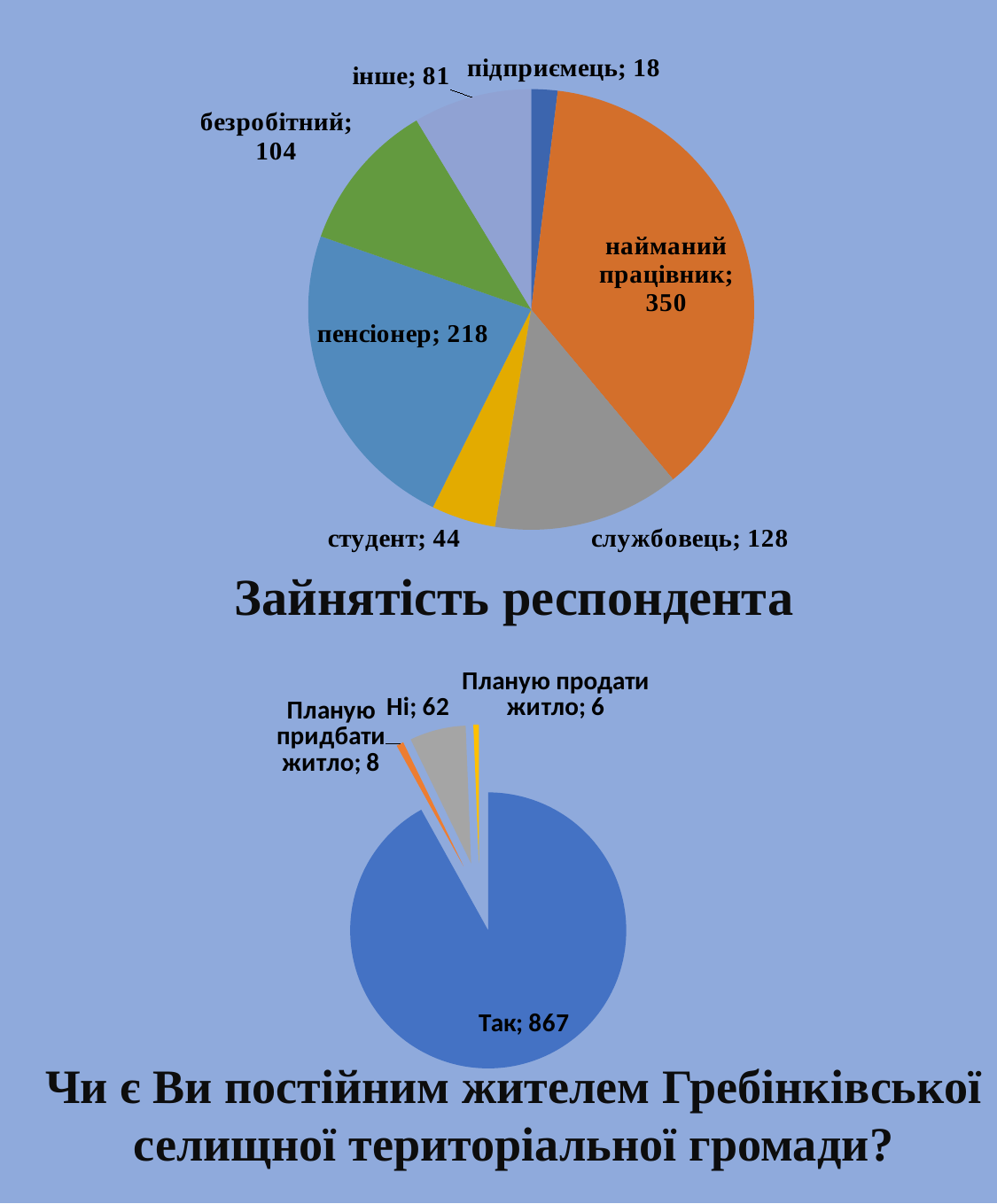
In the bottom chart ("Чи є Ви постійним жителем Гребінківської селищної територіальної громади?"), what is the value for "Ні"? 62 What type of chart is the top chart, "Зайнятість респондента"? pie chart In the chart titled "Зайнятість респондента", what is the value for "пенсіонер"? 218 In the chart titled "Зайнятість респондента", which is larger: "студент" or "інше"? інше In the chart titled "Зайнятість респондента", what is the difference between "службовець" and "безробітний"? 24 In the bottom chart ("Чи є Ви постійним жителем Гребінківської селищної територіальної громади?"), which category has the smallest value? Планую продати житло In the bottom chart ("Чи є Ви постійним жителем Гребінківської селищної територіальної громади?"), what is the difference between "Планую придбати житло" and "Планую продати житло"? 2 How many categories does the chart titled "Зайнятість респондента" show? 7 In the chart titled "Зайнятість респондента", which category has the smallest slice? підприємець In the bottom chart ("Чи є Ви постійним жителем Гребінківської селищної територіальної громади?"), how many respondents answered "Так"? 867 In the chart titled "Зайнятість респондента", how many respondents are "найманий працівник"? 350 In the chart titled "Зайнятість респондента", which category has the largest slice? найманий працівник